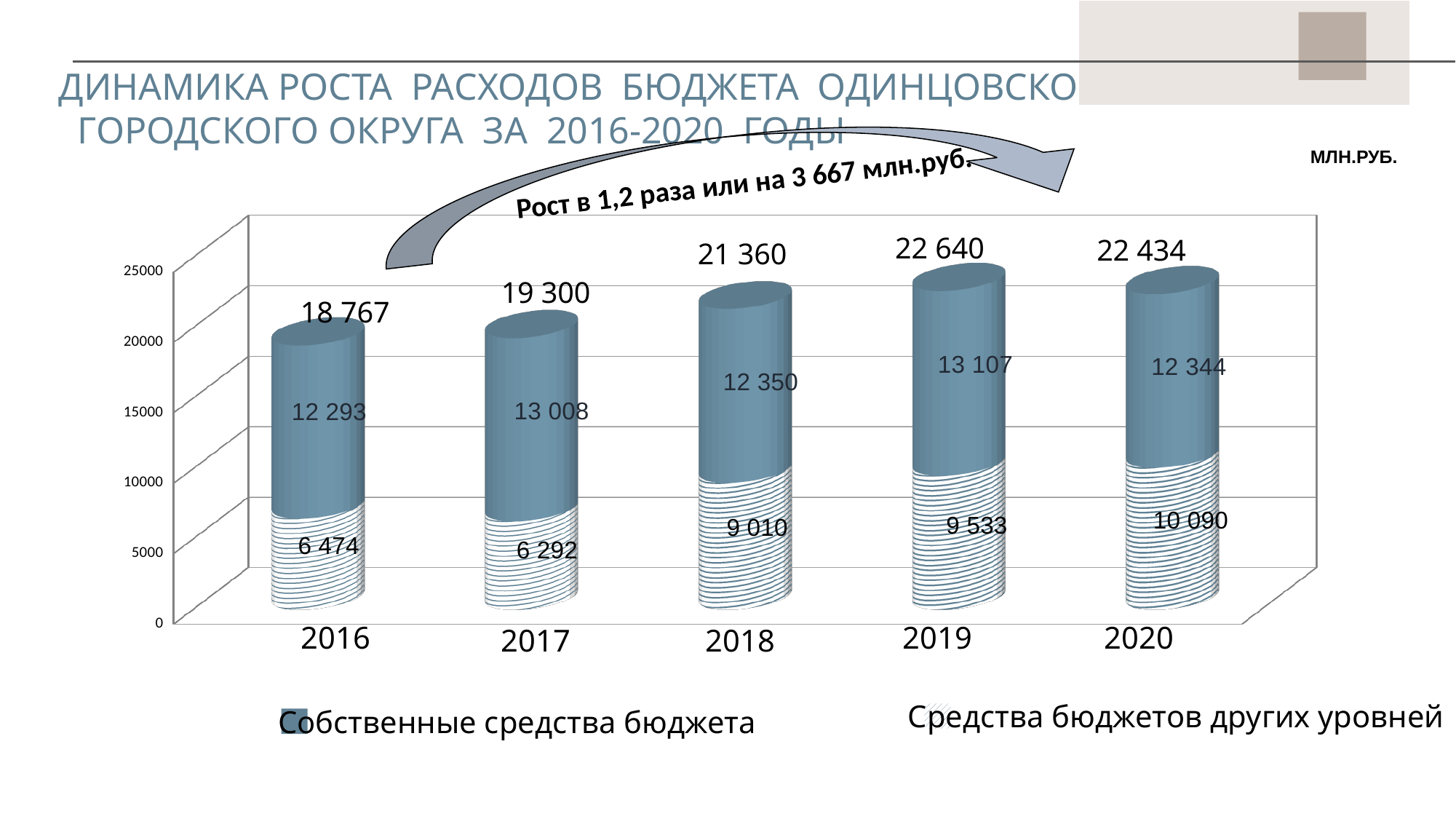
What is the value of 'Средства бюджетов других уровней' for 2020? 10 090 What is the value of 'Средства бюджетов других уровней' for 2017? 6 292 Which is larger: 'Собственные средства бюджета' in 2018 or 'Средства бюджетов других уровней' in 2018? Собственные средства бюджета What is the total budget expenditure shown for 2016? 18 767 How many series does the chart legend list? 2 What unit of measurement is indicated in the top right corner of the chart? МЛН.РУБ. How many years are shown on the x axis of the chart? 5 What kind of chart is shown on the slide? bar chart Which year has the lowest value for 'Средства бюджетов других уровней'? 2017 Which year has the highest total budget expenditure? 2019 What is the value of 'Собственные средства бюджета' for 2019? 13 107 What is the difference between the total for 2020 and the total for 2016? 3 667